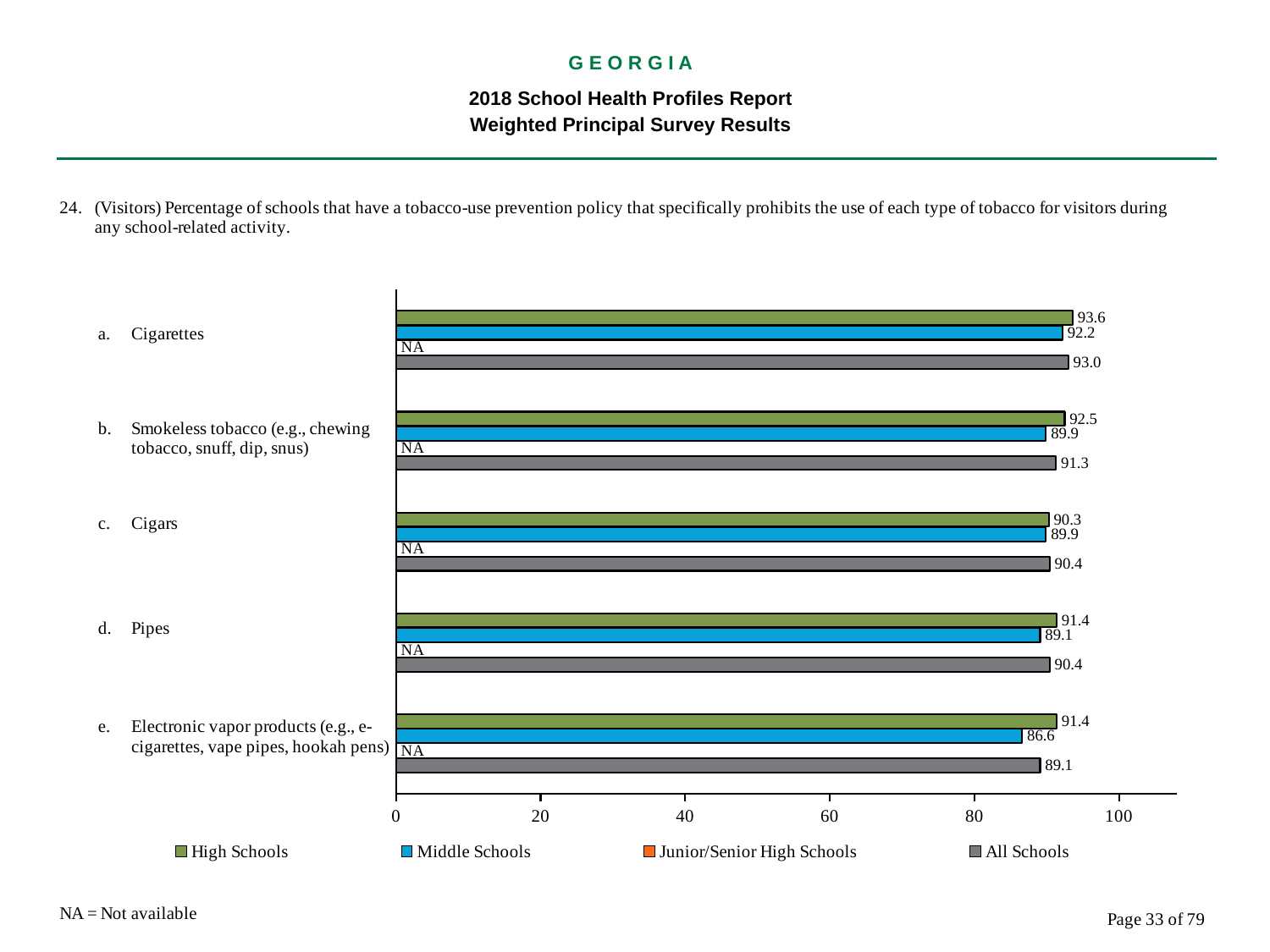
What kind of chart is shown on the slide? bar chart Which category has the highest value for High Schools? Cigarettes Is the All Schools value for Cigarettes greater or less than 80? greater What is the value for High Schools for Cigarettes? 93.6 How many categories of tobacco are shown in the chart? 5 What is the difference between the High Schools and Middle Schools values for Electronic vapor products? 4.8 What is shown for Junior/Senior High Schools for Pipes? NA How many series does the legend list? 4 What is the value for All Schools for Smokeless tobacco? 91.3 What is the value for Middle Schools for Electronic vapor products? 86.6 Which is larger for Cigars: the High Schools value or the Middle Schools value? High Schools Which category has the lowest value for Middle Schools? Electronic vapor products (e.g., e-cigarettes, vape pipes, hookah pens)